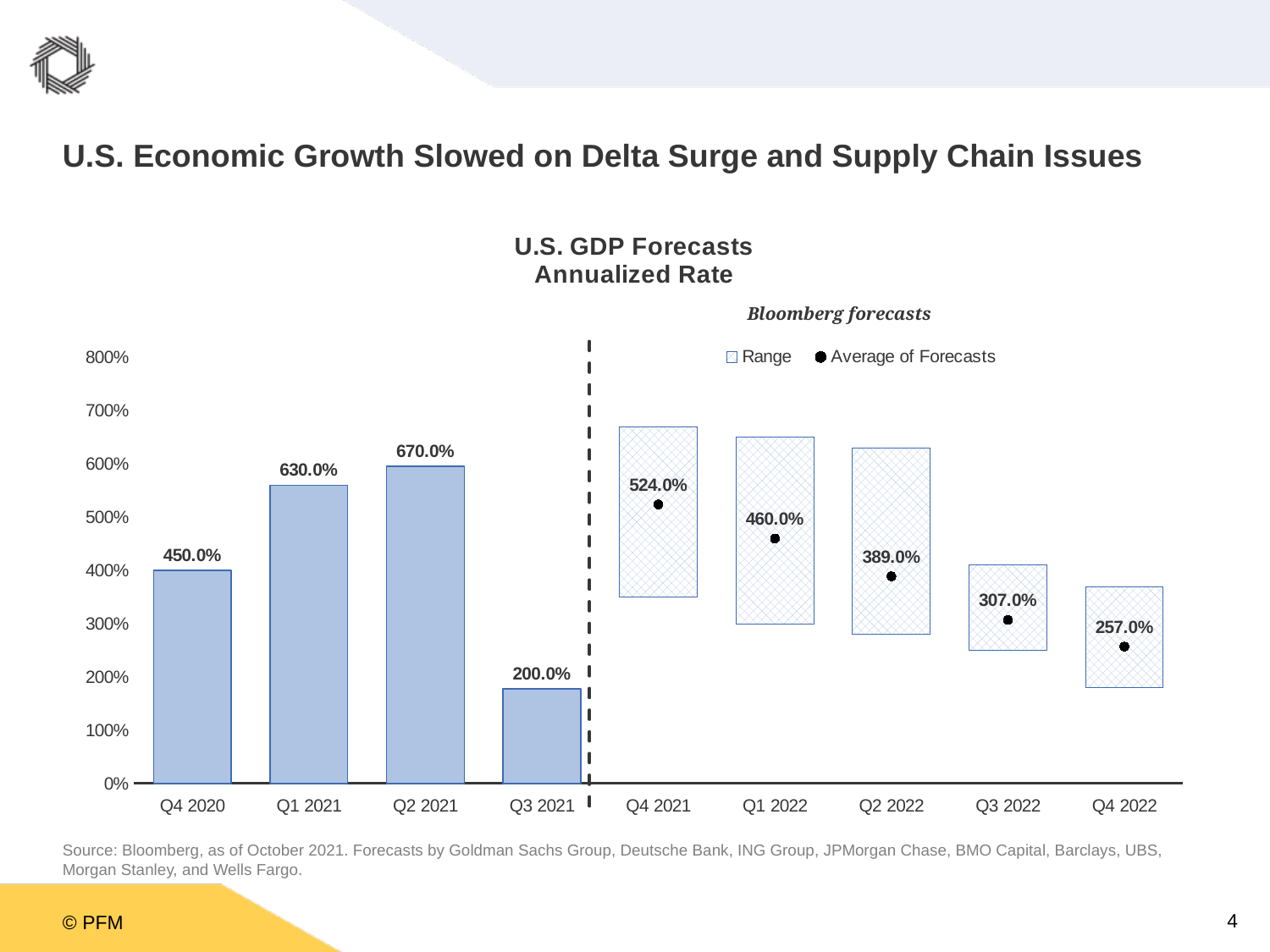
What is the difference between the Q1 2021 value and the Q4 2020 value? 180.0% What is the value for Q3 2021 in the U.S. GDP Forecasts chart? 200.0% How many entries does the legend of the U.S. GDP Forecasts chart list? 2 How many quarters are shown on the x axis of the U.S. GDP Forecasts chart? 9 Which quarter has the lowest labeled value in the U.S. GDP Forecasts chart? Q3 2021 What is the Average of Forecasts value for Q1 2022? 460.0% What is the value for Q2 2021 in the U.S. GDP Forecasts chart? 670.0% What is the title of the chart on the slide? U.S. GDP Forecasts Annualized Rate What is the Average of Forecasts value for Q4 2022? 257.0% Which quarter has the highest labeled value in the U.S. GDP Forecasts chart? Q2 2021 Do the Average of Forecasts values rise or fall from Q4 2021 to Q4 2022? fall Which is larger, the Average of Forecasts for Q4 2021 or for Q2 2022? Q4 2021